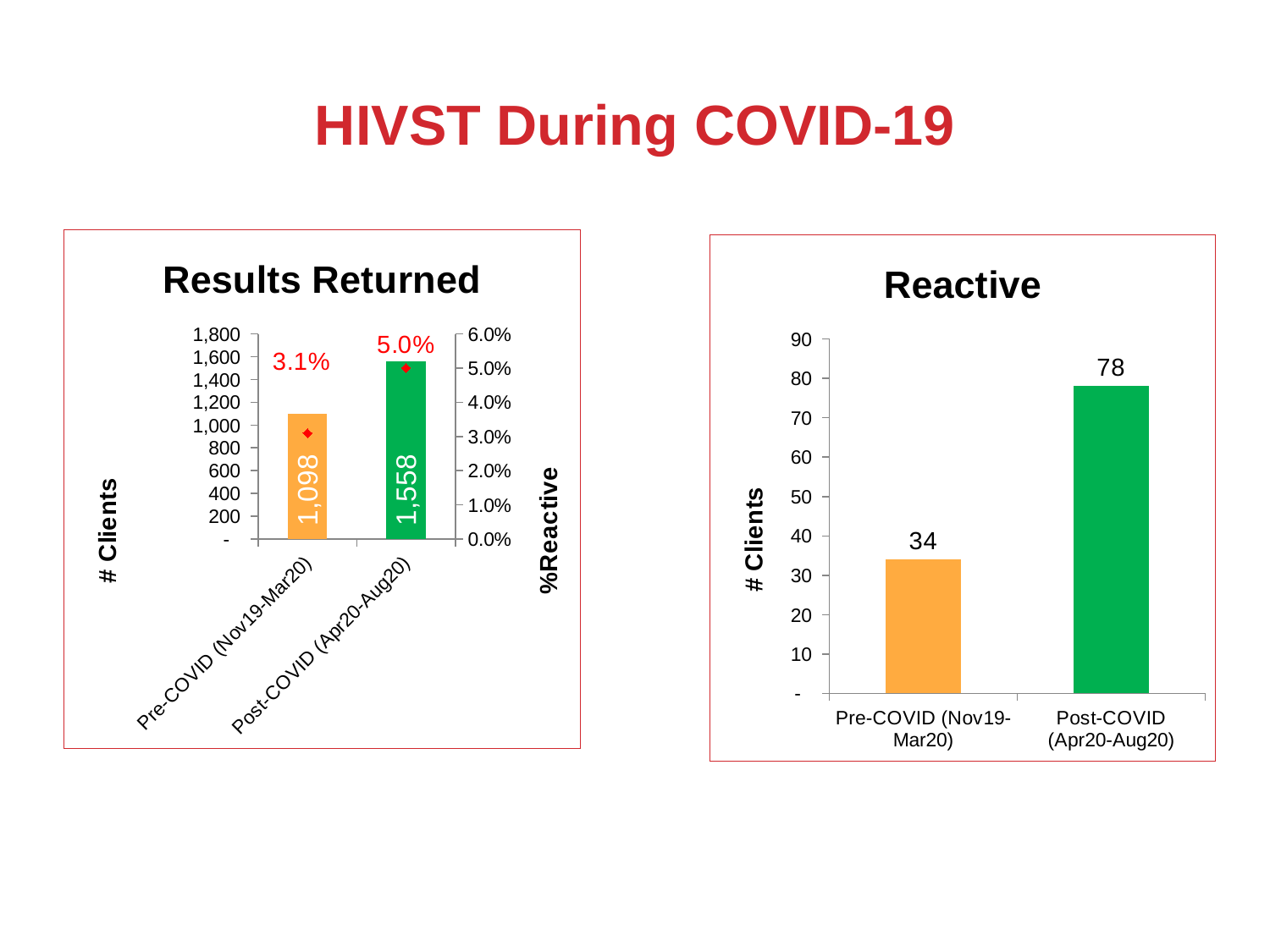
In the 'Reactive' chart, what is the difference in clients between Post-COVID and Pre-COVID? 44 In the 'Results Returned' chart, what is the %Reactive value for Post-COVID (Apr20-Aug20)? 5.0% In the 'Results Returned' chart, what is the %Reactive value for Pre-COVID (Nov19-Mar20)? 3.1% In the 'Results Returned' chart, what is the difference in number of clients between Post-COVID and Pre-COVID? 460 In the 'Results Returned' chart, what is the number of clients for Post-COVID (Apr20-Aug20)? 1,558 In the 'Reactive' chart, which category has the highest number of clients? Post-COVID (Apr20-Aug20) In the 'Reactive' chart, what is the number of clients for Pre-COVID (Nov19-Mar20)? 34 What type of chart is the 'Reactive' chart? Bar chart In the 'Results Returned' chart, what is the label of the right-hand vertical axis? %Reactive In the 'Reactive' chart, how many categories are shown on the x axis? 2 In the 'Results Returned' chart, what is the number of clients for Pre-COVID (Nov19-Mar20)? 1,098 In the 'Reactive' chart, what is the number of clients for Post-COVID (Apr20-Aug20)? 78